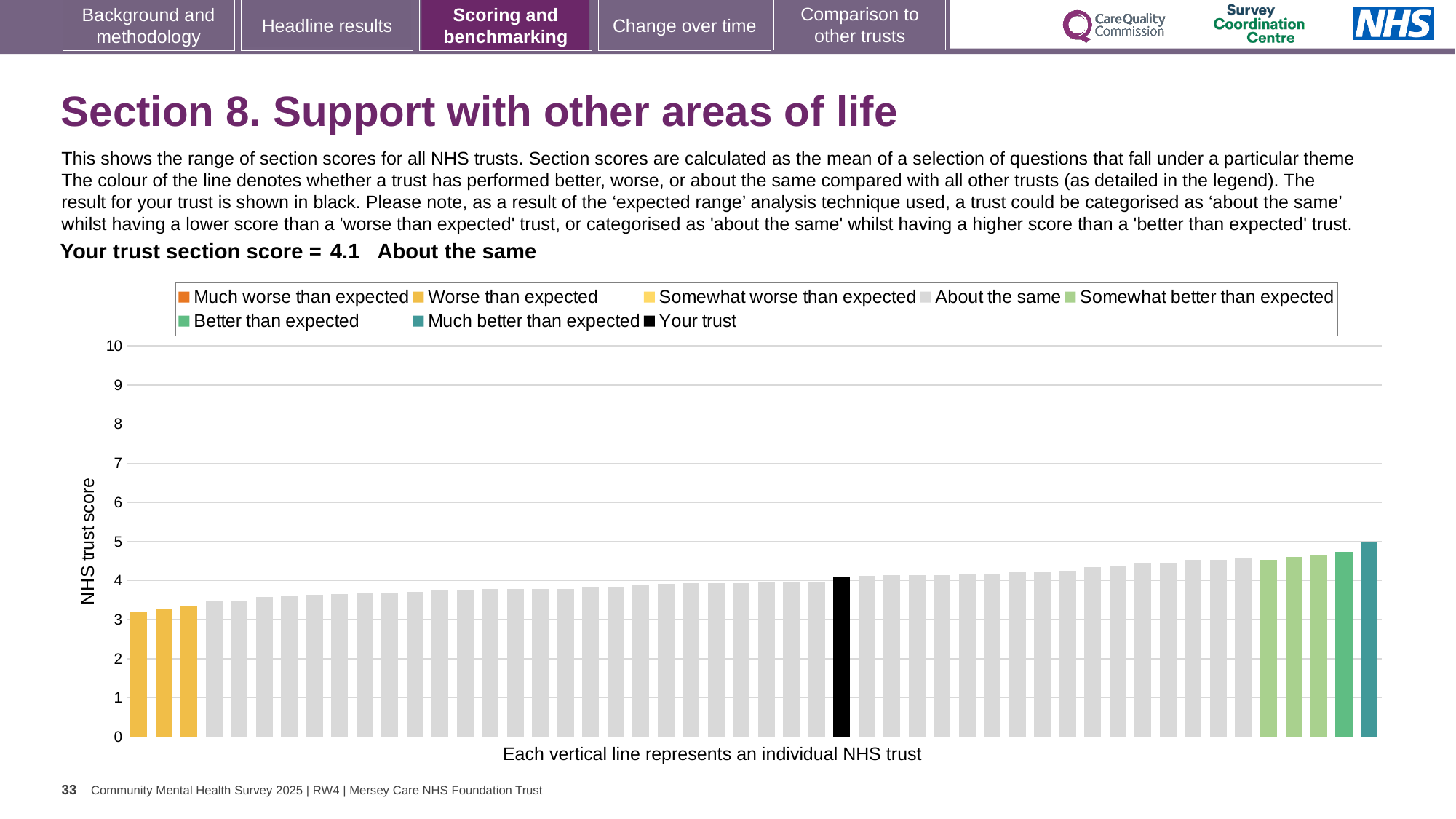
Is the value for your trust greater or less than 4? greater Is the value of the lowest bar greater or less than 4? less What is the section score for your trust? 4.1 What kind of chart is shown on the slide? bar chart Do the bar values rise or fall from left to right along the x axis? rise How many bars are coloured as 'Worse than expected'? 3 What colour is the bar representing your trust? black How many entries does the chart legend list? 8 Which category is your trust placed in for this section? About the same Is the value of the highest bar greater or less than 6? less What is the label on the y axis of the chart? NHS trust score Which is larger, the leftmost bar or the rightmost bar? the rightmost bar